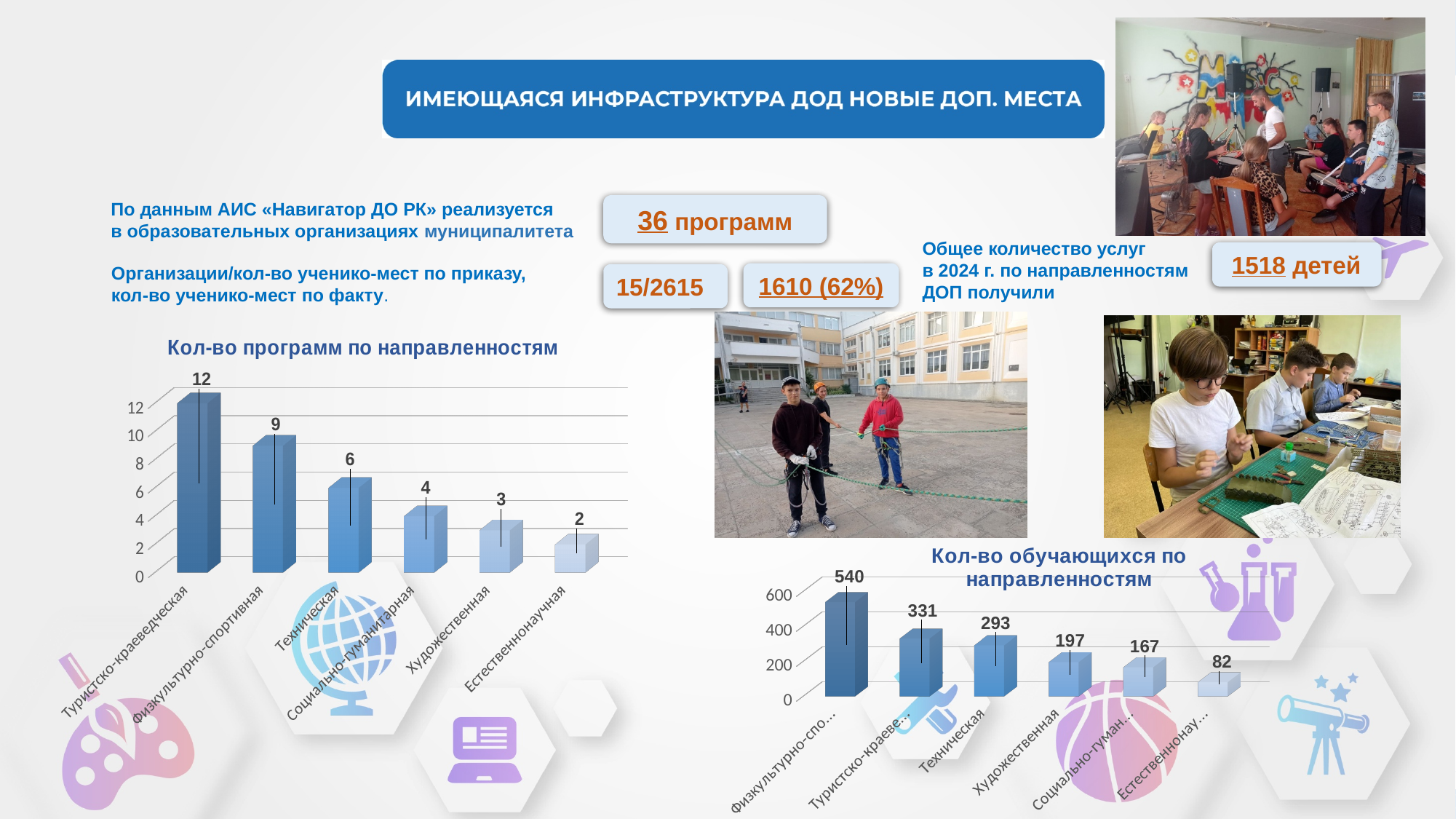
In the chart 'Кол-во обучающихся по направленностям', what is the difference between Техническая and Художественная? 96 In the chart 'Кол-во программ по направленностям', do the values rise or fall from left to right? fall In the chart 'Кол-во программ по направленностям', what is the difference between Физкультурно-спортивная and Художественная? 6 In the chart 'Кол-во программ по направленностям', which category has the lowest value? Естественнонаучная What type of chart is 'Кол-во обучающихся по направленностям'? bar chart In the chart 'Кол-во программ по направленностям', how many categories are shown? 6 In the chart 'Кол-во обучающихся по направленностям', what is the value for Техническая? 293 In the chart 'Кол-во обучающихся по направленностям', which is larger: Техническая or Художественная? Техническая In the chart 'Кол-во обучающихся по направленностям', what is the highest value shown? 540 In the chart 'Кол-во программ по направленностям', what is the value for Туристско-краеведческая? 12 In the chart 'Кол-во программ по направленностям', what is the value for Техническая? 6 In the chart 'Кол-во обучающихся по направленностям', what is the value for Художественная? 197